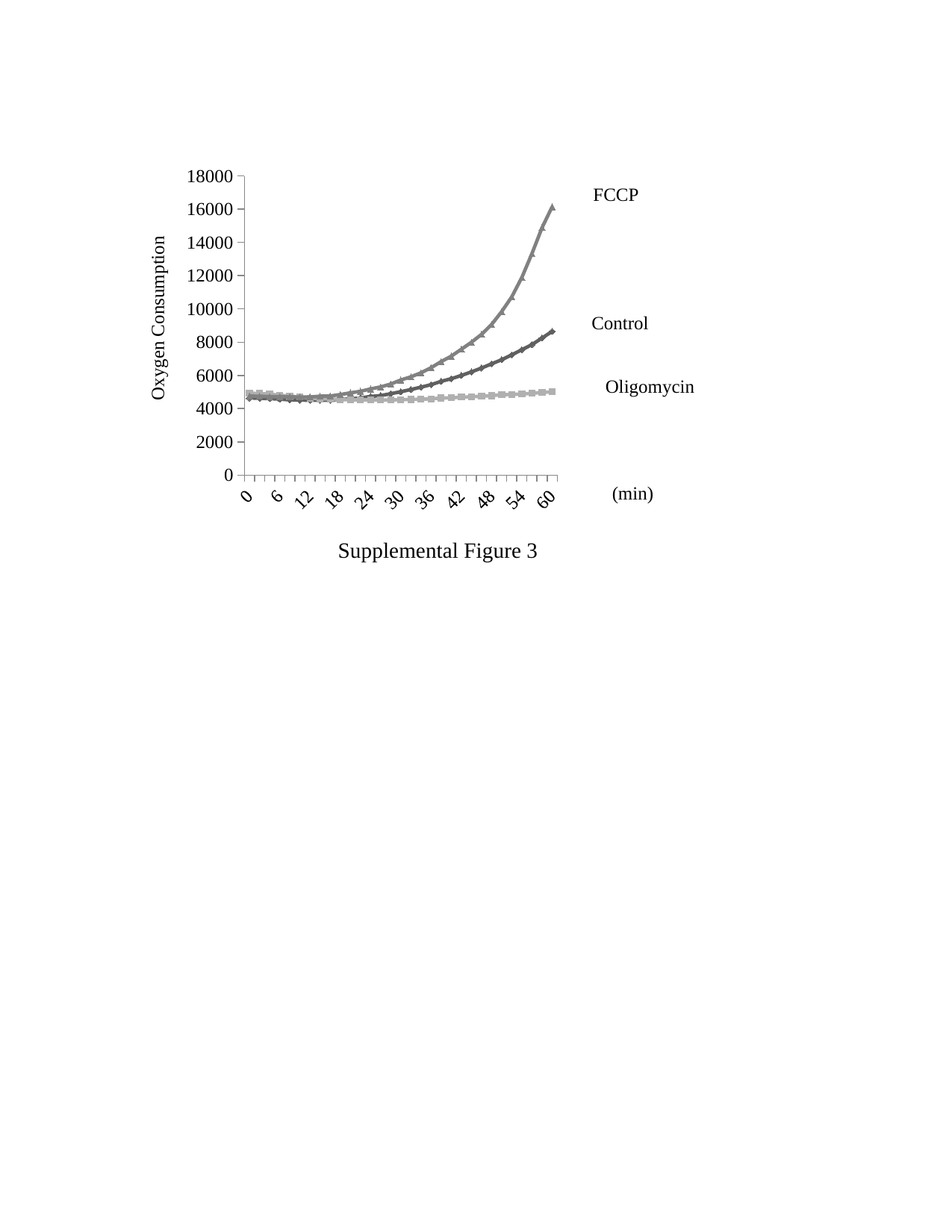
Which series has the lowest oxygen consumption at 60 min? Oligomycin Which series has the highest oxygen consumption at 60 min? FCCP Is the value for Control at 60 min greater or less than 6000? greater Is the value for Oligomycin at 60 min greater or less than 6000? less Which is larger at 60 min, the FCCP value or the Control value? FCCP What unit is given for the horizontal axis? min Does the FCCP series rise or fall between 18 min and 60 min? rise What kind of chart is shown on the slide? line chart What is the label of the vertical axis? Oxygen Consumption Is the value for FCCP at 60 min greater or less than 14000? greater How many series are plotted on the chart? 3